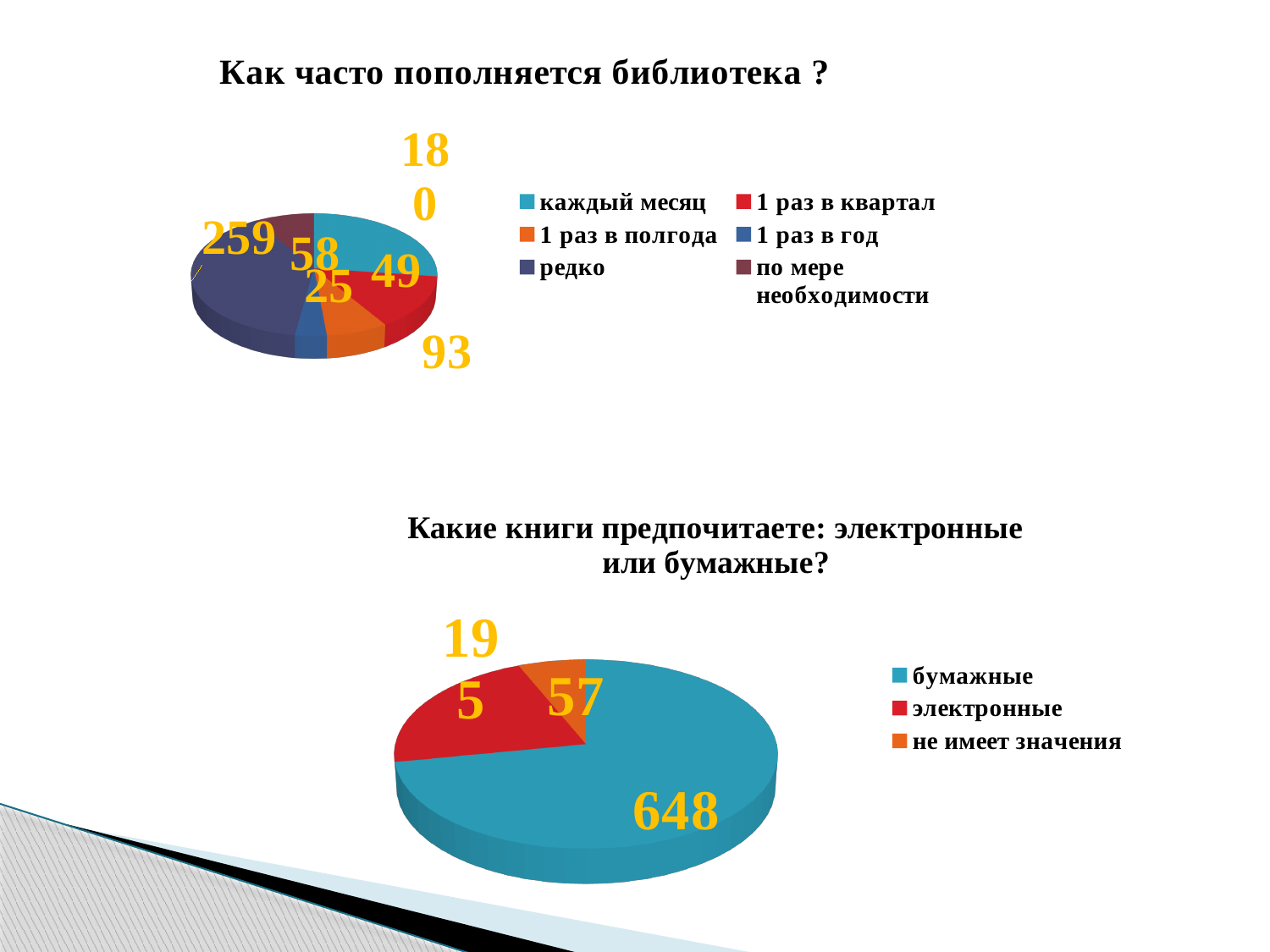
In the chart titled "Как часто пополняется библиотека ?", what is the value for "редко"? 259 In the chart titled "Какие книги предпочитаете: электронные или бумажные?", what is the value for "бумажные"? 648 In the chart titled "Какие книги предпочитаете: электронные или бумажные?", which category has the smallest value? не имеет значения How many categories does the legend of the chart titled "Какие книги предпочитаете: электронные или бумажные?" list? 3 In the chart titled "Как часто пополняется библиотека ?", what is the value for "каждый месяц"? 180 In the chart titled "Как часто пополняется библиотека ?", what colour is the slice for "каждый месяц"? teal What kind of chart is the chart titled "Какие книги предпочитаете: электронные или бумажные?"? pie chart In the chart titled "Какие книги предпочитаете: электронные или бумажные?", what is the value for "электронные"? 195 In the chart titled "Как часто пополняется библиотека ?", which is larger: the value for "редко" or the value for "каждый месяц"? редко In the chart titled "Какие книги предпочитаете: электронные или бумажные?", what is the difference between the values for "бумажные" and "электронные"? 453 In the chart titled "Как часто пополняется библиотека ?", which category has the largest value? редко How many categories does the legend of the chart titled "Как часто пополняется библиотека ?" list? 6